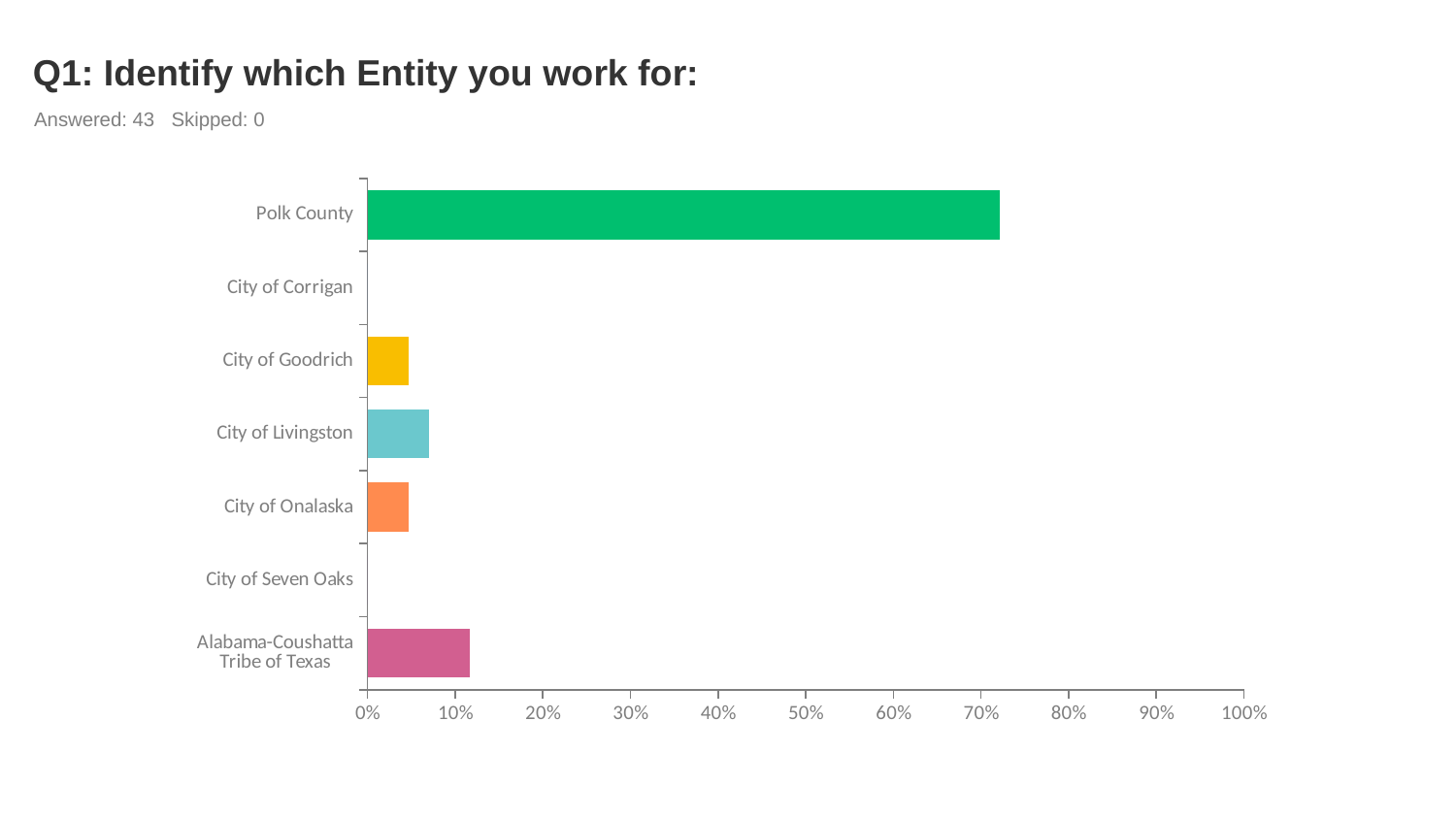
Which is larger, the value for Alabama-Coushatta Tribe of Texas or the value for City of Livingston? Alabama-Coushatta Tribe of Texas How many respondents answered the question according to the slide? 43 Is the value for Polk County greater or less than 60%? greater What is the title of the chart? Q1: Identify which Entity you work for: Which entities show no bar at all on the chart? City of Corrigan and City of Seven Oaks Which entity has the highest share of respondents? Polk County What kind of chart is shown on the slide? Bar chart Is the value for Alabama-Coushatta Tribe of Texas greater or less than 20%? less Which is larger, the value for City of Livingston or the value for City of Goodrich? City of Livingston Is the value for City of Goodrich greater or less than 10%? less How many entity categories are listed on the chart? 7